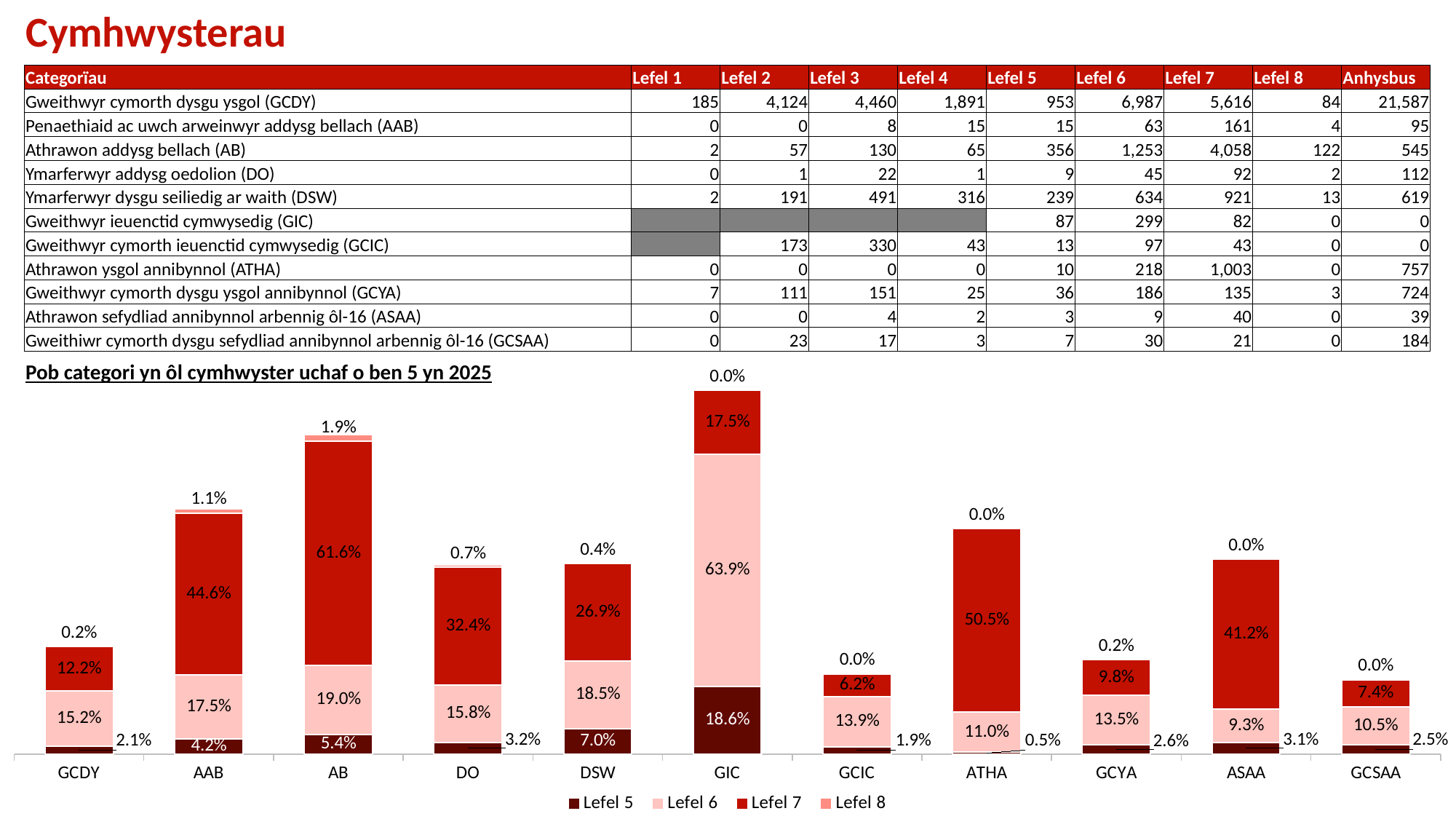
What is the Lefel 8 value for AAB in the chart? 1.1% How many categories are shown along the x axis of the chart? 11 What is the total of the stacked bar for GIC in the chart? 100.0% Which has the larger Lefel 7 value in the chart, DO or DSW? DO What is the Lefel 7 value for AB in the chart? 61.6% What is the Lefel 5 value for DSW in the chart? 7.0% What is the difference between the Lefel 7 values for AB and AAB in the chart? 17.0% Which category has the highest Lefel 7 value in the chart? AB What is the Lefel 6 value for GIC in the chart? 63.9% How many series does the chart legend list? 4 Which category has the lowest Lefel 5 value in the chart? ATHA What kind of chart is shown below the table on the slide? Stacked bar chart